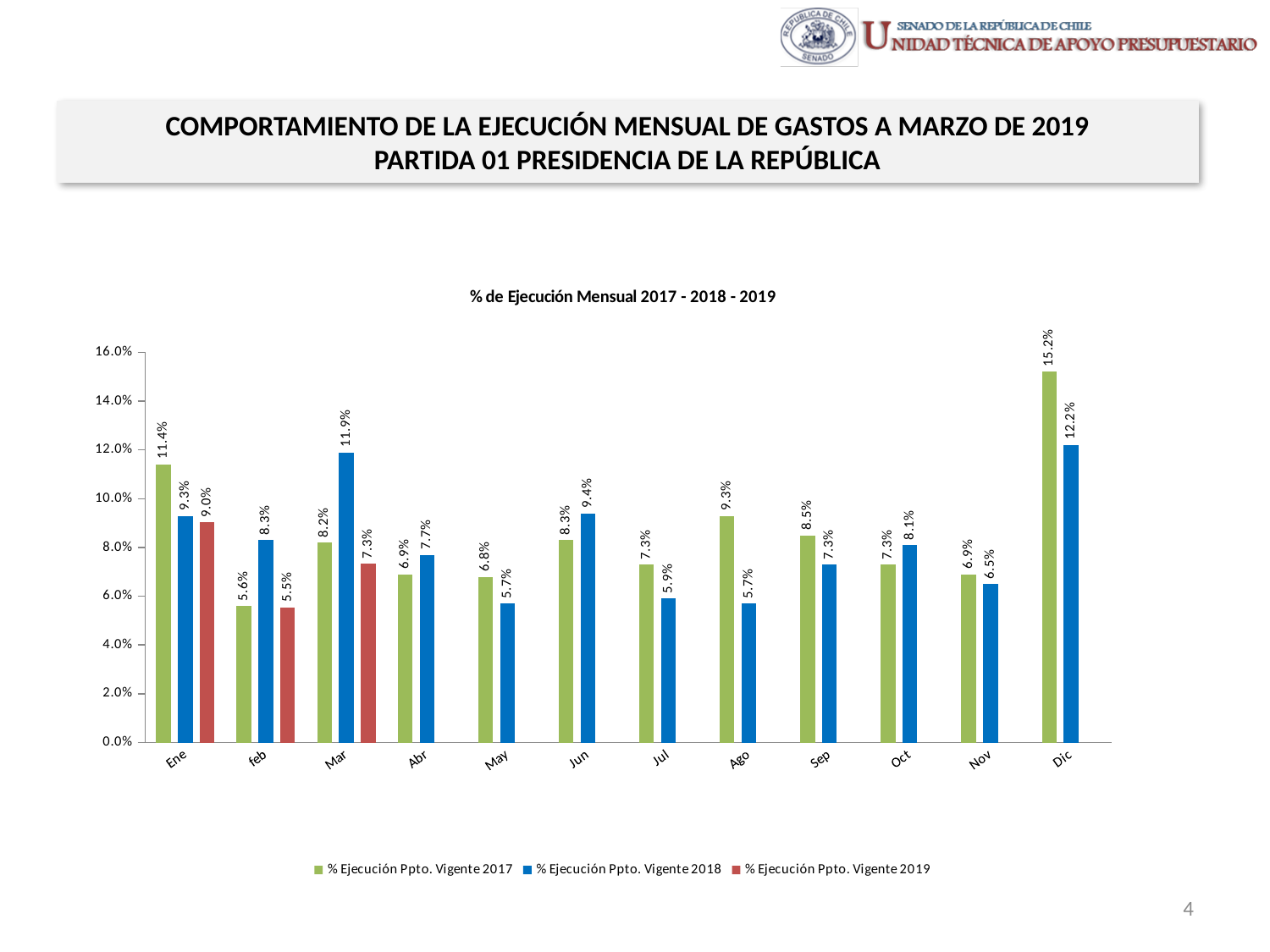
Is the value for % Ejecución Ppto. Vigente 2018 in Ago greater or less than 6.0%? less Which is larger in Mar: the 2017 value or the 2018 value? 2018 (11.9%) What kind of chart is shown on the slide? Bar chart In which month is the % Ejecución Ppto. Vigente 2017 series lowest? feb What is the value for % Ejecución Ppto. Vigente 2018 in Dic? 12.2% How many months are shown on the x axis? 12 In which month is the % Ejecución Ppto. Vigente 2017 series highest? Dic What is the title of the chart? % de Ejecución Mensual 2017 - 2018 - 2019 What is the difference between the 2017 and 2018 values in Ene? 2.1% What is the value for % Ejecución Ppto. Vigente 2019 in Mar? 7.3% What is the value for % Ejecución Ppto. Vigente 2017 in Ago? 9.3% How many series does the legend list? 3